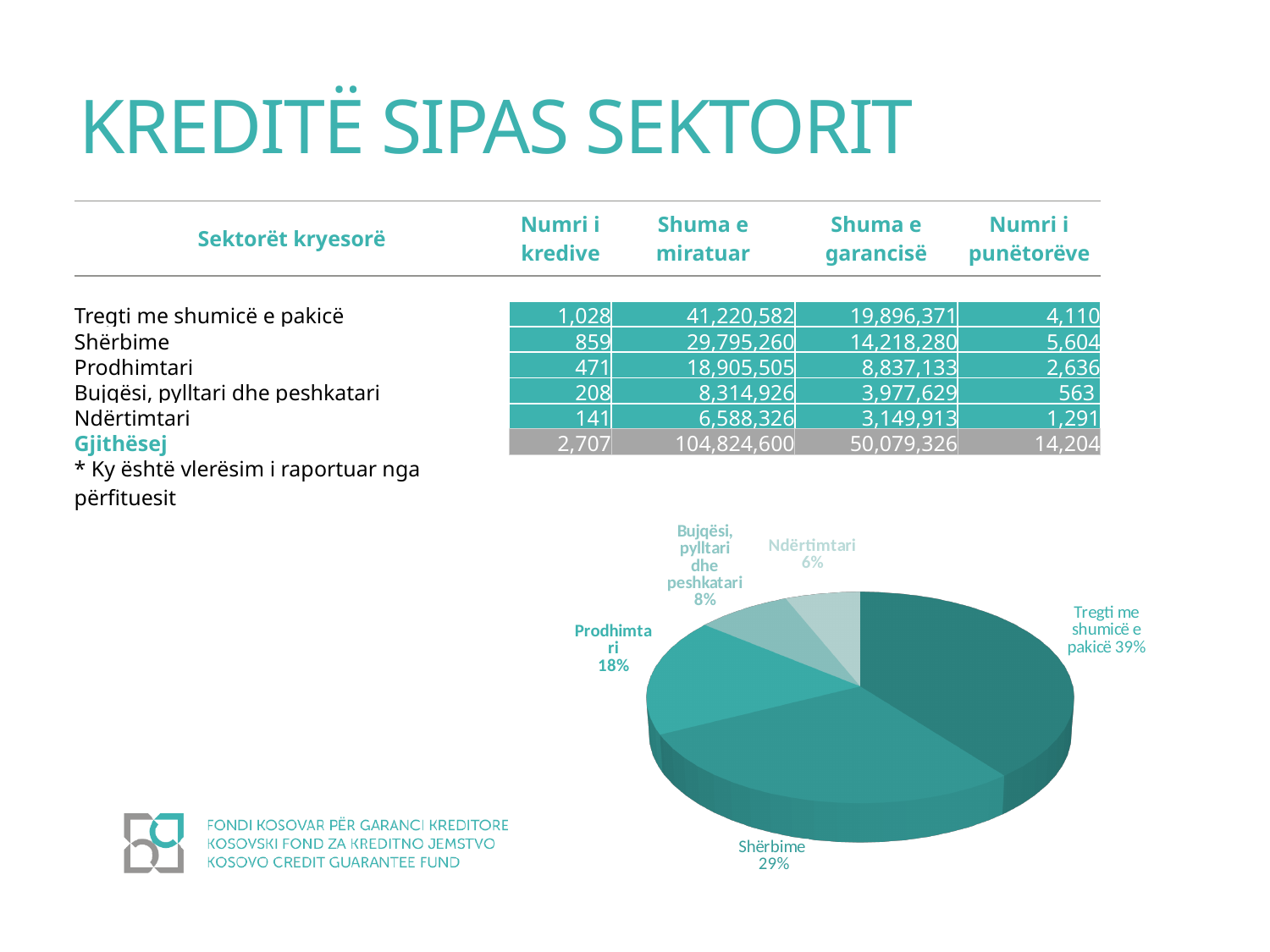
Which sector has the smallest slice of the pie chart? Ndërtimtari What share of the pie does Bujqësi, pylltari dhe peshkatari have? 8% How many slices does the pie chart have? 5 What share of the pie does Prodhimtari have? 18% What kind of chart is shown on the slide? pie chart What is the combined share of the Bujqësi, pylltari dhe peshkatari and Ndërtimtari slices? 14% What is the difference in percentage points between the Tregti me shumicë e pakicë slice and the Shërbime slice? 10 What share of the pie does Shërbime have? 29% Which sector has the largest slice of the pie chart? Tregti me shumicë e pakicë Which slice is larger, Prodhimtari or Bujqësi, pylltari dhe peshkatari? Prodhimtari